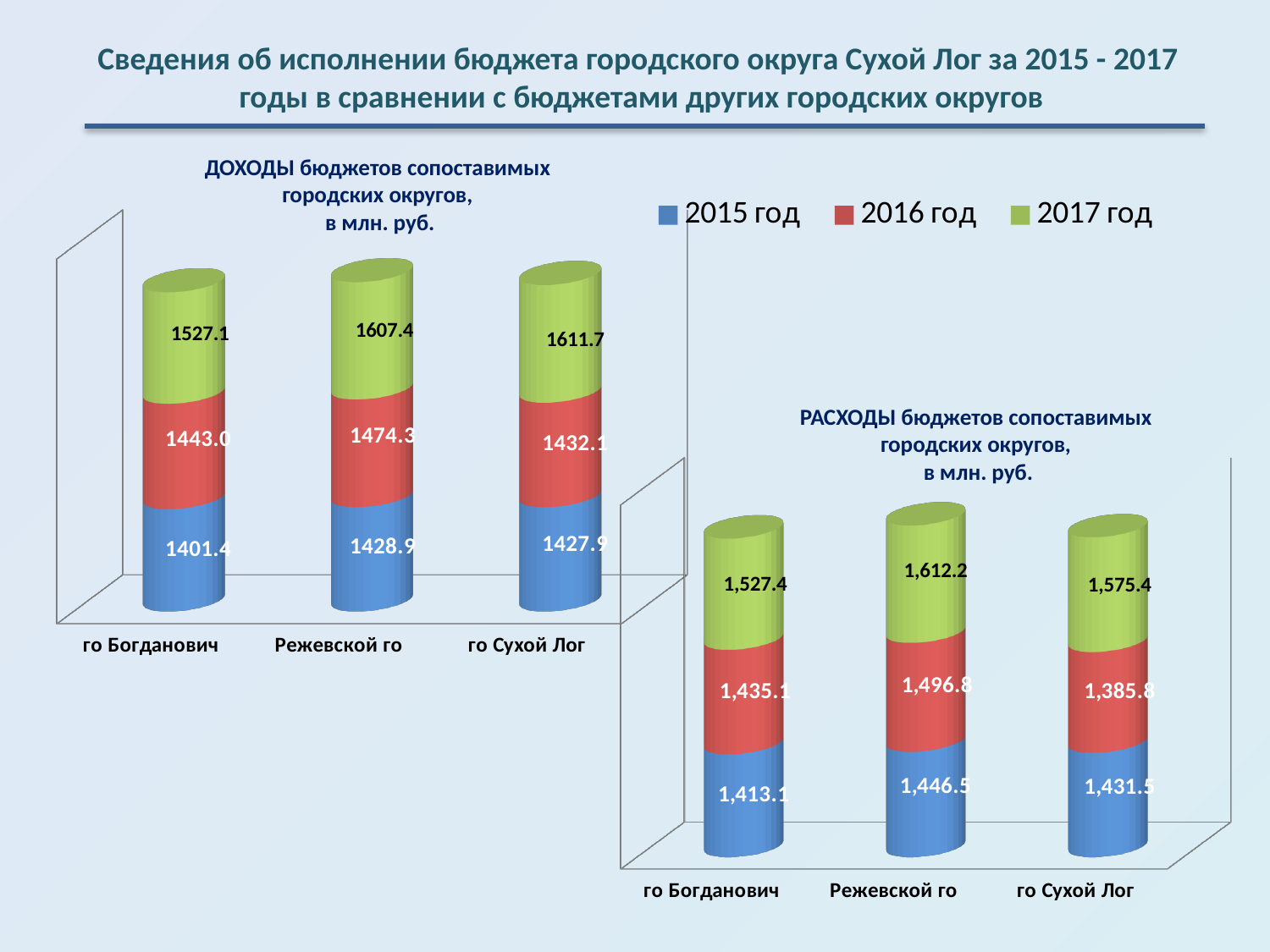
In the РАСХОДЫ chart (right), which is larger: the 2015 год value for Режевской го or for го Богданович? Режевской го In the ДОХОДЫ chart (left), which city district has the highest 2017 год value? го Сухой Лог In the РАСХОДЫ chart (right), what is the 2015 год value for го Сухой Лог? 1,431.5 How many series does the legend list? 3 What type of chart is the РАСХОДЫ chart (right)? Stacked bar chart In the ДОХОДЫ chart (left), what is the 2017 год value for го Сухой Лог? 1611.7 In the ДОХОДЫ chart (left), what is the total of the stacked bar for го Богданович? 4371.5 In the РАСХОДЫ chart (right), which city district has the lowest 2016 год value? го Сухой Лог In the РАСХОДЫ chart (right), what is the 2016 год value for Режевской го? 1,496.8 In the ДОХОДЫ chart (left), what is the difference between the 2017 год values for го Сухой Лог and го Богданович? 84.6 How many city districts are shown in the ДОХОДЫ chart (left)? 3 In the ДОХОДЫ chart (left), what is the 2015 год value for го Богданович? 1401.4